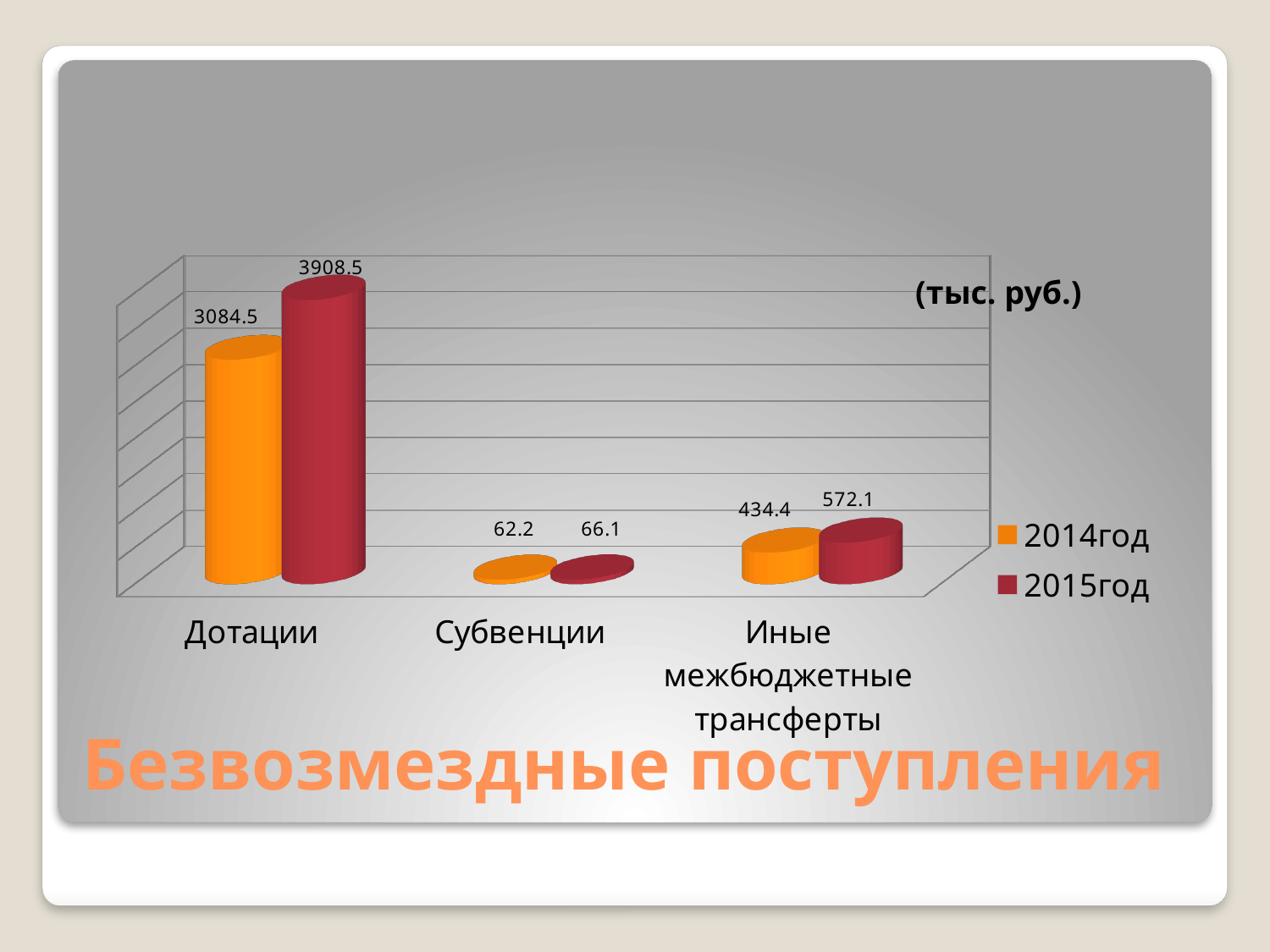
Which is larger for Иные межбюджетные трансферты: the 2014год value or the 2015год value? 2015год Which category has the highest value in the 2015год series? Дотации What is the value for Дотации in the 2015год series? 3908.5 What is the value for Иные межбюджетные трансферты in the 2014год series? 434.4 What is the difference between the 2015год and 2014год values for Иные межбюджетные трансферты? 137.7 What kind of chart is shown on the slide? Bar chart How many series does the legend list? 2 How many categories are shown on the x axis? 3 Which category has the lowest value in the 2014год series? Субвенции What is the value for Дотации in the 2014год series? 3084.5 What is the difference between the 2015год and 2014год values for Дотации? 824.0 What is the value for Субвенции in the 2015год series? 66.1